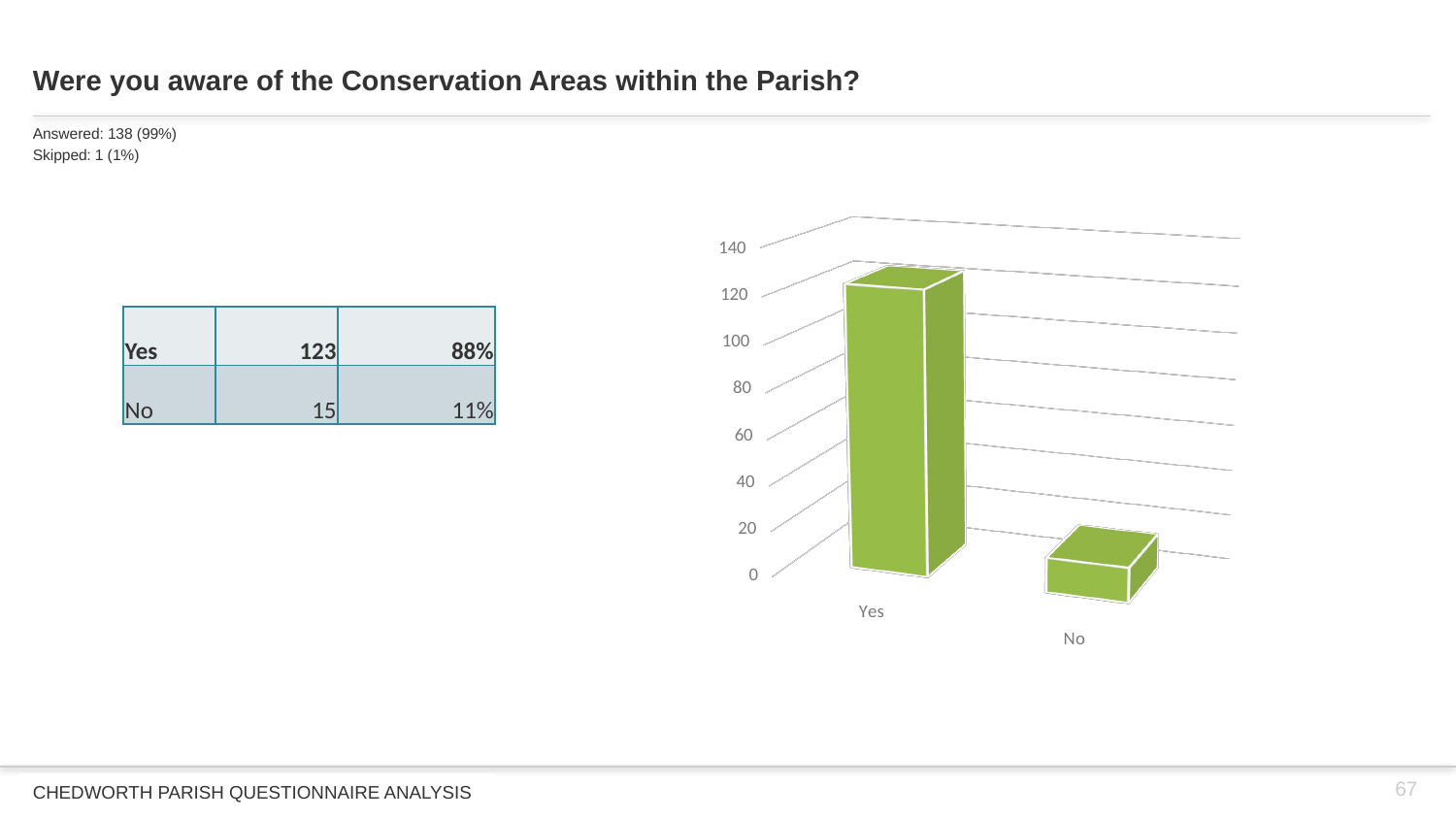
According to the table on the slide, how many respondents answered No? 15 Which is larger, the value for Yes or the value for No? Yes What kind of chart is shown on the slide? bar chart How many categories does the chart show? 2 According to the table on the slide, how many respondents answered Yes? 123 Is the value for Yes greater or less than 100? greater Which category has the highest value in the chart? Yes Is the value for No greater or less than 20? less Which category has the lowest value in the chart? No According to the table on the slide, what percentage of respondents answered Yes? 88% What is the highest value shown on the chart's vertical axis? 140 Using the values in the table, what is the difference between the number of Yes and No responses? 108